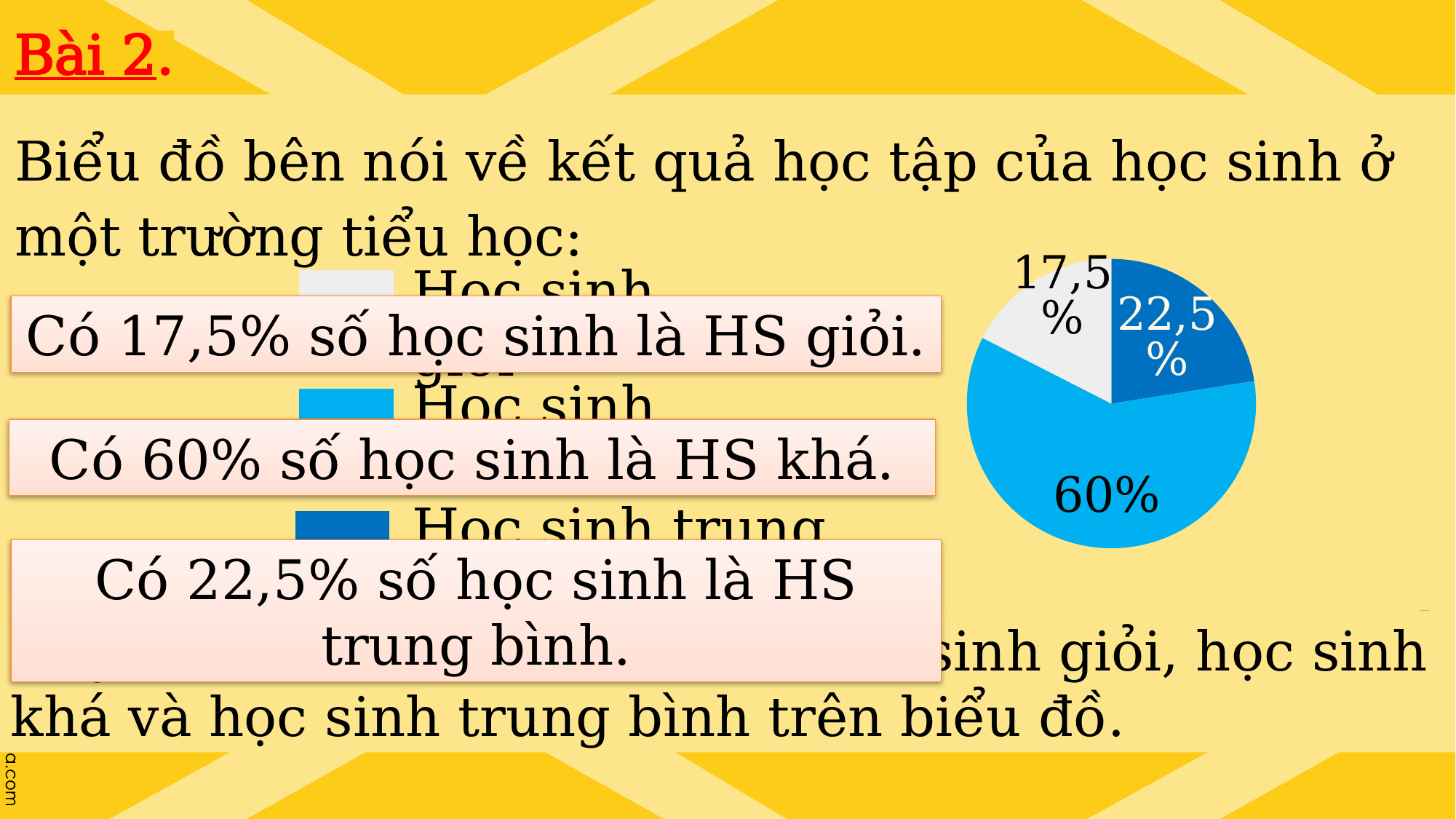
What percentage of students are 'học sinh trung bình' according to the pie chart? 22,5% What is the difference between the share of 'học sinh khá' and the share of 'học sinh trung bình'? 37,5% What percentage of students are 'học sinh khá' according to the pie chart? 60% What percentage of students are 'học sinh giỏi' according to the pie chart? 17,5% What is the combined share of 'học sinh giỏi' and 'học sinh trung bình' in the pie chart? 40% What kind of chart is shown on the slide? pie chart How many slices does the pie chart have? 3 What colour is the slice representing 'học sinh khá' in the pie chart? light blue Which is larger in the pie chart: the share of 'học sinh trung bình' or the share of 'học sinh giỏi'? Học sinh trung bình Which group has the smallest slice of the pie chart? Học sinh giỏi Which group has the largest slice of the pie chart? Học sinh khá What is the difference between the share of 'học sinh trung bình' and the share of 'học sinh giỏi'? 5%